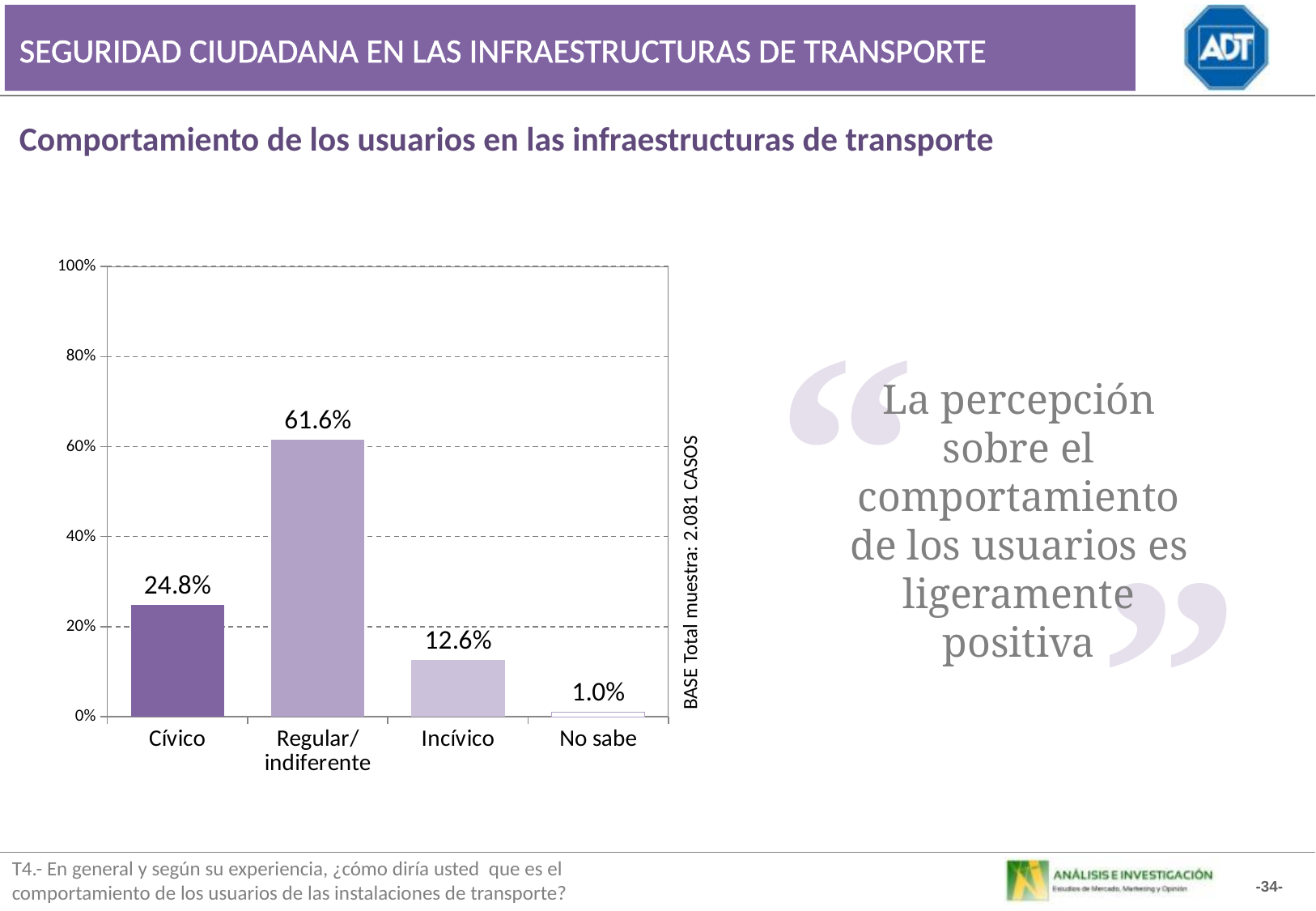
How many categories are shown on the x axis? 4 Which is larger, the value for Cívico or the value for Incívico? Cívico Which category has the highest value? Regular/indiferente What is the value for Cívico? 24.8% What is the difference between the values for Regular/indiferente and Cívico? 36.8% Is the value for Regular/indiferente greater or less than 60%? greater What is the base (total sample) stated next to the chart? 2.081 CASOS Which category has the lowest value? No sabe What is the value for Regular/indiferente? 61.6% What kind of chart is shown on the slide? bar chart What is the value for Incívico? 12.6% What is the value for No sabe? 1.0%